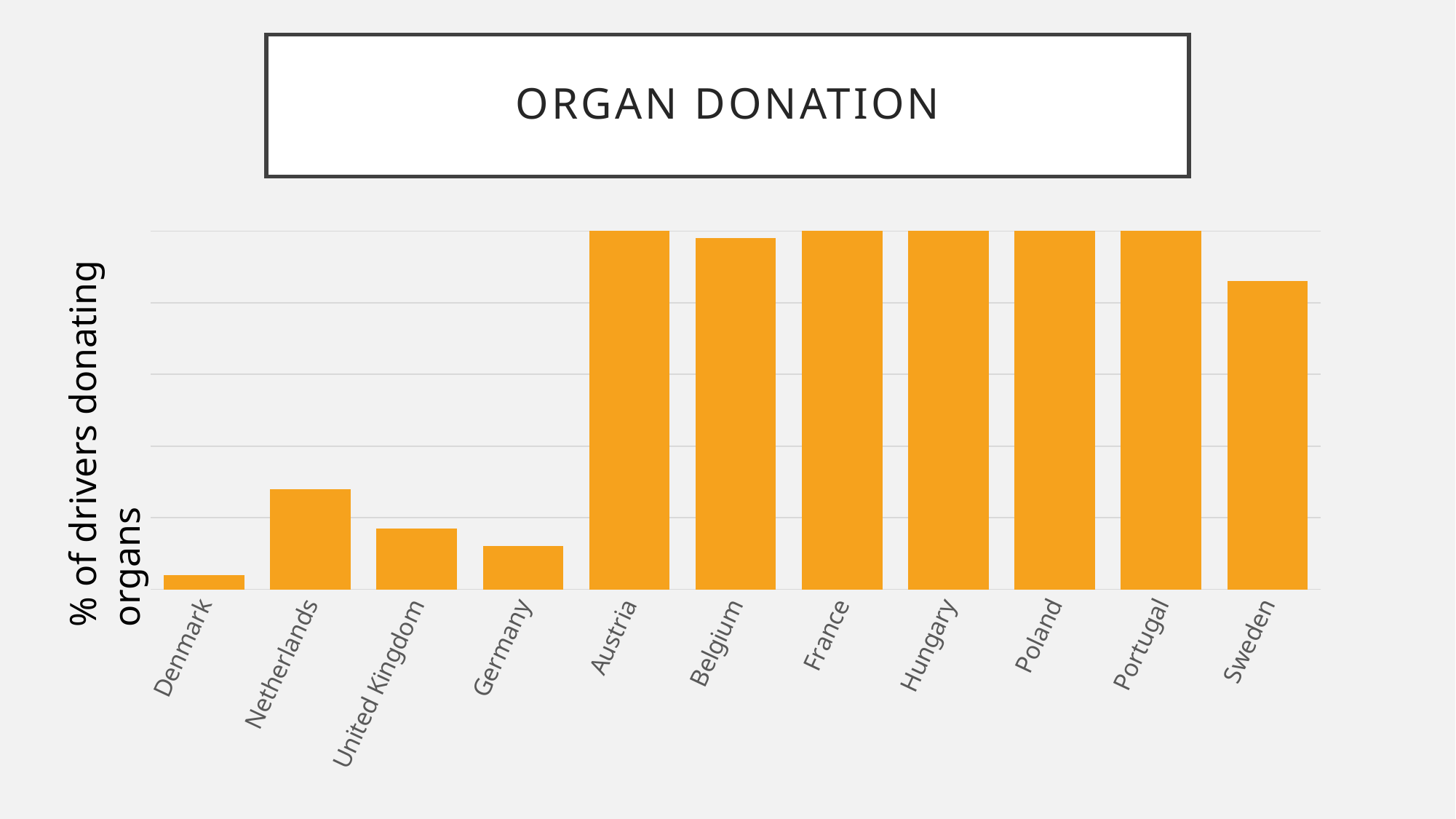
Which country has the lowest value in the chart? Denmark Which has the larger value, Austria or Sweden? Austria What kind of chart is shown on the slide? bar chart What is the label on the y axis of the chart? % of drivers donating organs Which country has the lowest value among Austria, Belgium, France, Hungary, Poland, Portugal and Sweden? Sweden Which has the larger value, Netherlands or United Kingdom? Netherlands Which has the larger value, Germany or Denmark? Germany How many countries are shown on the x axis of the chart? 11 What is the title of the slide? ORGAN DONATION